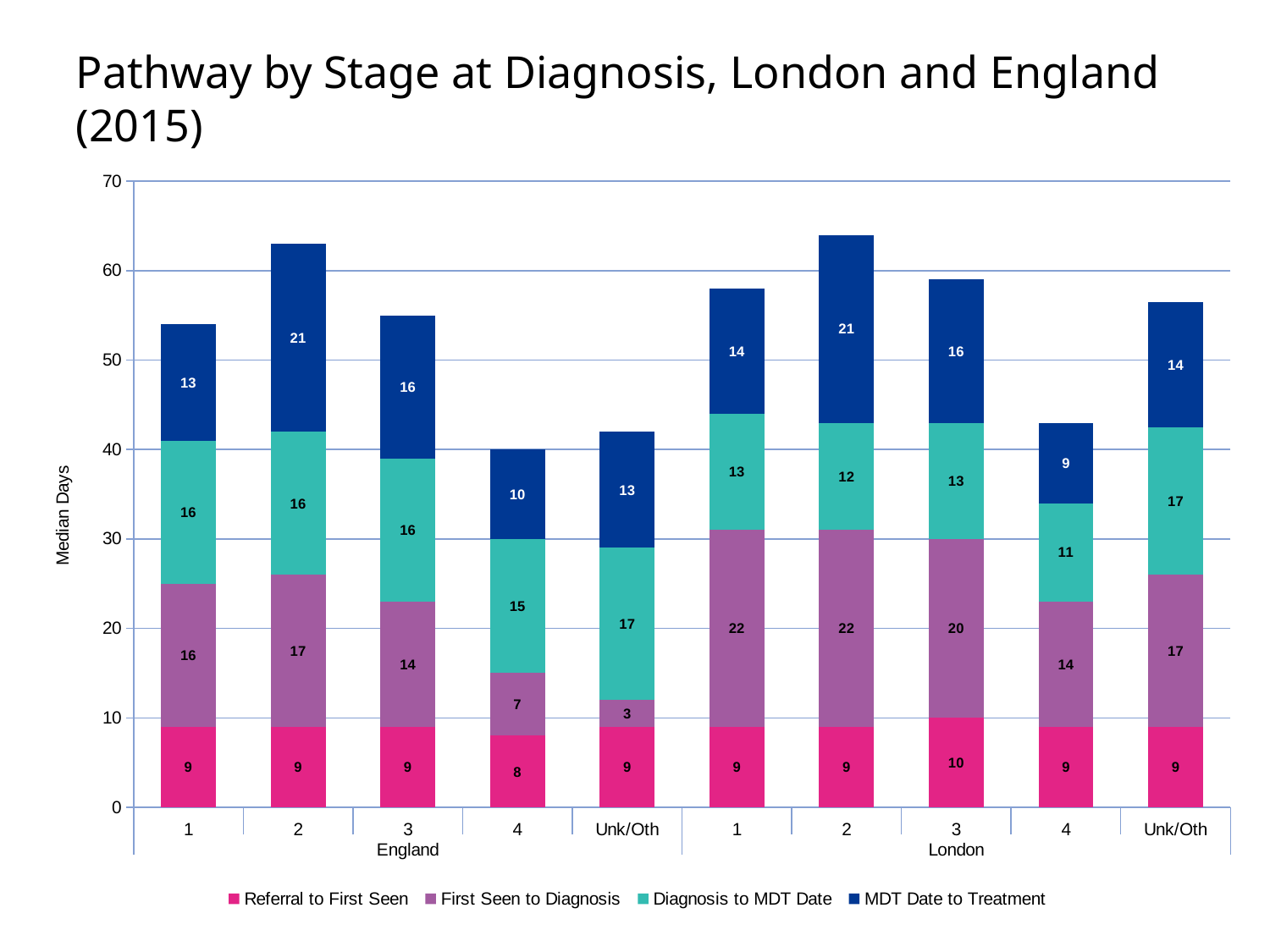
What is the First Seen to Diagnosis value for stage Unk/Oth in England? 3 Is the total for stage 2 in London greater or less than 60? greater How many bars are plotted in the chart? 10 What type of chart is shown on the slide? Stacked bar chart What is the Referral to First Seen value for stage 3 in London? 10 What is the MDT Date to Treatment value for stage 2 in London? 21 What is the Diagnosis to MDT Date value for stage 4 in London? 11 What is the difference between the First Seen to Diagnosis values for stage 1 in London and stage 1 in England? 6 What is the total of the stacked bar for stage 2 in England? 63 What is the total of the stacked bar for stage 4 in London? 43 Which stage has the lowest total median days in England? 4 How many series does the legend list? 4